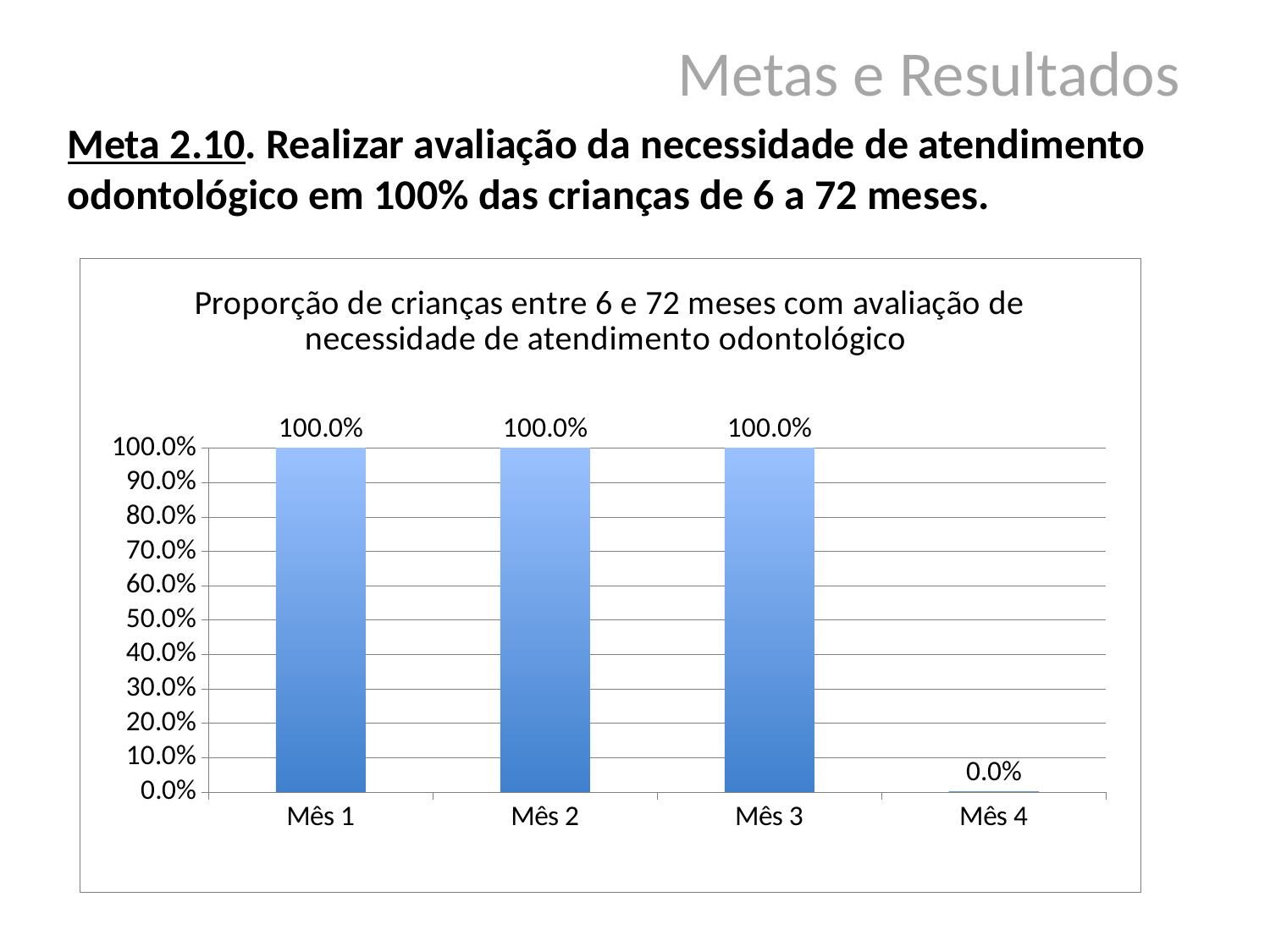
What kind of chart is shown on the slide? Bar chart What is the value for Mês 1? 100.0% What is the highest value shown on the y axis? 100.0% How many categories are shown on the x axis? 4 What is the value for Mês 3? 100.0% What is the difference between the values for Mês 2 and Mês 4? 100.0% Which category has the lowest value? Mês 4 Which is larger, the value for Mês 3 or the value for Mês 4? Mês 3 What is the title of the chart? Proporção de crianças entre 6 e 72 meses com avaliação de necessidade de atendimento odontológico Is the value for Mês 2 greater or less than 50.0%? greater What is the value for Mês 4? 0.0% Is the value for Mês 4 greater or less than 10.0%? less